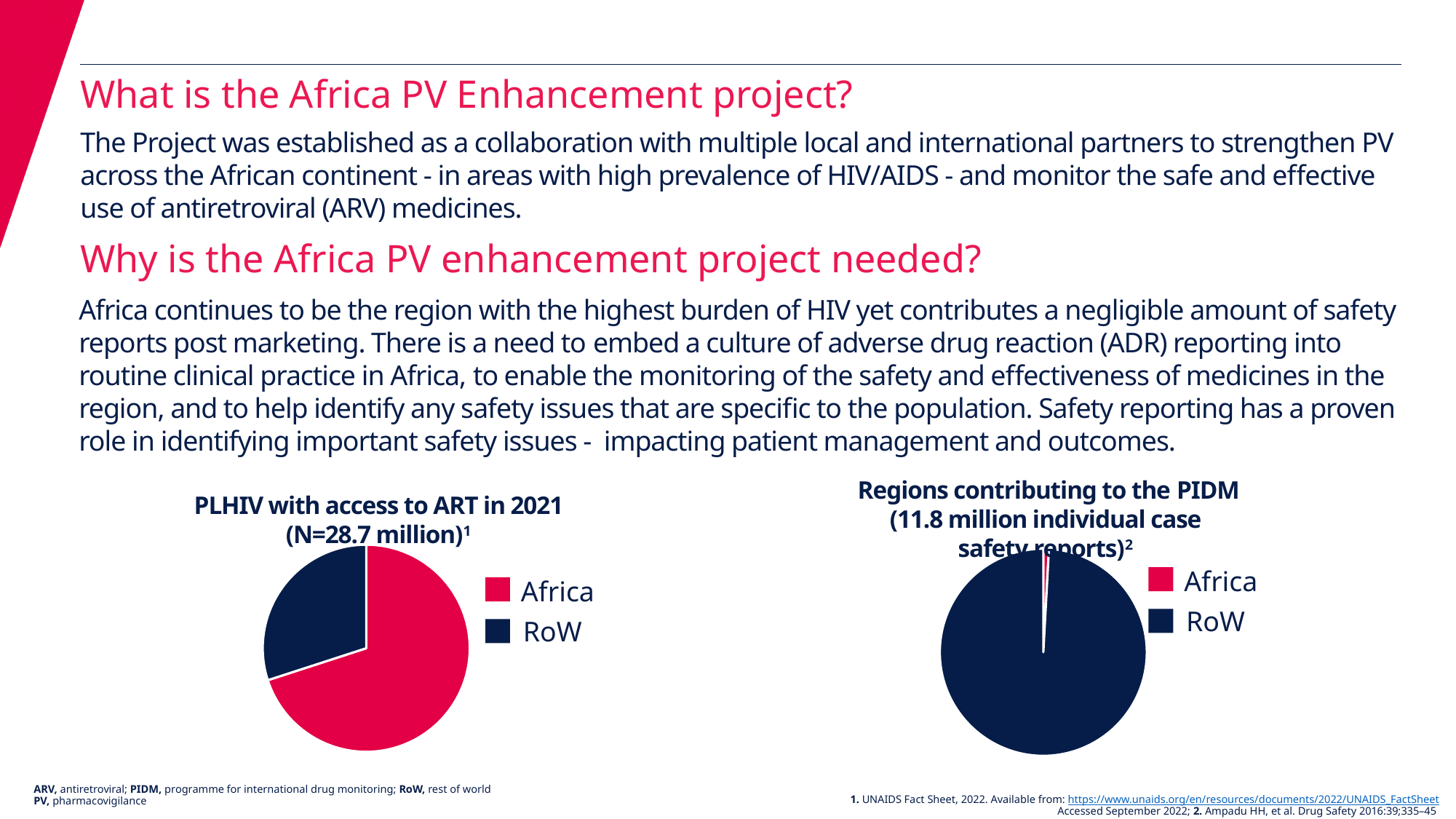
How many entries does the legend of the right chart, "Regions contributing to the PIDM", list? 2 In the right chart, "Regions contributing to the PIDM", is the slice for Africa larger or smaller than the slice for RoW? Smaller What kind of chart is the right chart titled "Regions contributing to the PIDM"? Pie chart In the right chart, "Regions contributing to the PIDM", which region has the largest slice? RoW In the left chart, "PLHIV with access to ART in 2021", which region has the largest slice? Africa In the right chart, "Regions contributing to the PIDM", which region has the smallest slice? Africa What total N is given in the title of the left chart, "PLHIV with access to ART in 2021"? N=28.7 million What kind of chart is the left chart titled "PLHIV with access to ART in 2021"? Pie chart In the left chart, "PLHIV with access to ART in 2021", is the slice for Africa larger or smaller than the slice for RoW? Larger In the right chart, "Regions contributing to the PIDM", what colour represents RoW? Dark navy blue In the left chart, "PLHIV with access to ART in 2021", which region has the smallest slice? RoW How many slices does the left chart, "PLHIV with access to ART in 2021", have? 2